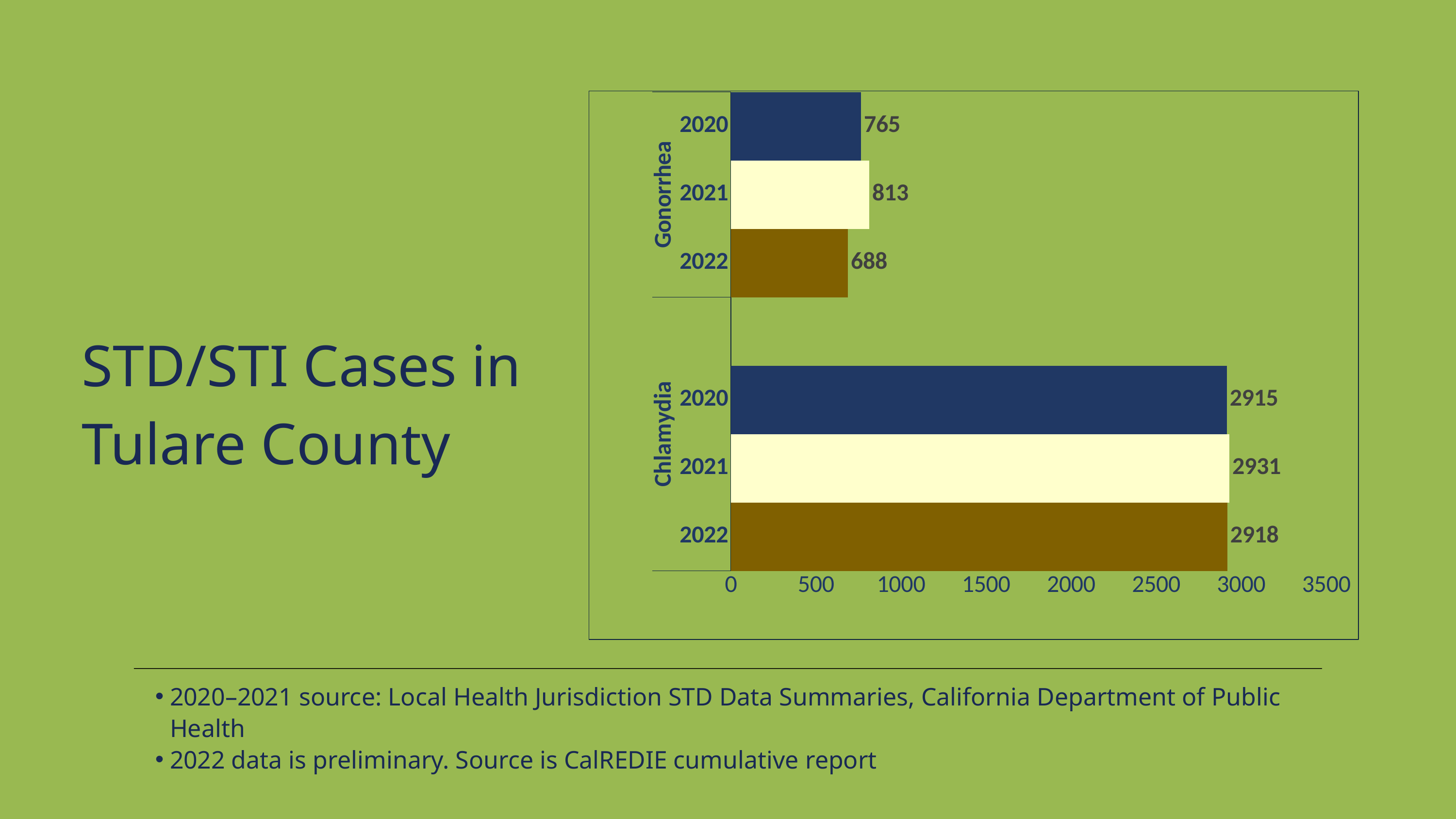
What is the difference between Gonorrhea cases in 2021 and 2022? 125 Which year had the lowest number of Gonorrhea cases? 2022 Is the value for Chlamydia in 2020 greater or less than 2500? greater What is the title of the slide containing the chart? STD/STI Cases in Tulare County What kind of chart is shown on the slide? bar chart How many Chlamydia cases were reported in 2022? 2918 Which year had the highest number of Chlamydia cases? 2021 What is the value for Gonorrhea in 2020? 765 Which is larger: Gonorrhea cases in 2020 or Gonorrhea cases in 2022? 2020 How many bars are plotted in the chart? 6 How many Gonorrhea cases were reported in 2021? 813 What is the difference between Chlamydia cases in 2021 and 2020? 16